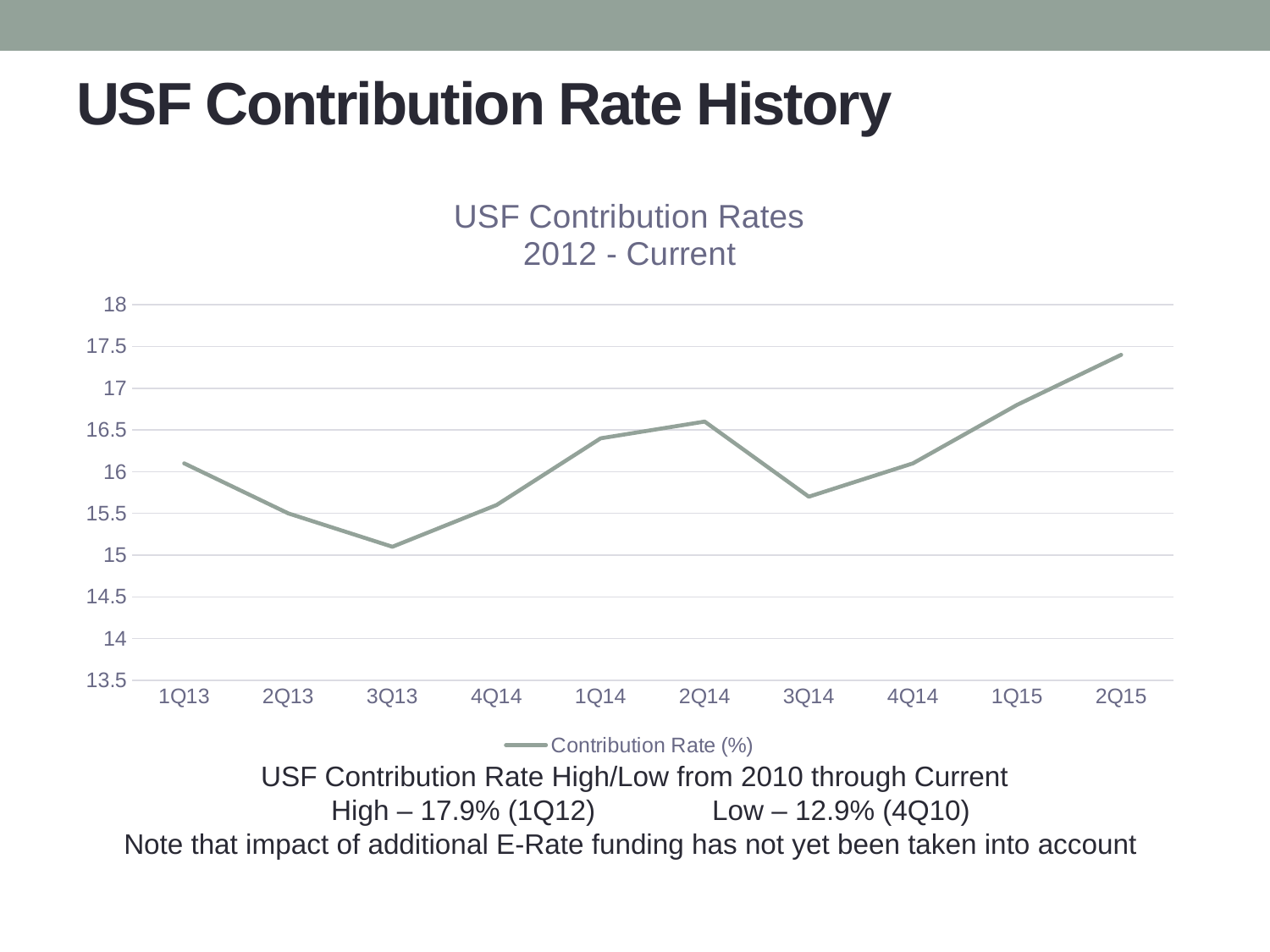
Is the contribution rate for 3Q14 greater or less than 16? less What is the title of the chart? USF Contribution Rates 2012 - Current Is the contribution rate for 2Q15 greater or less than 17? greater How many series does the legend list? 1 Is the contribution rate for 3Q13 greater or less than 15.5? less Which quarter has the highest contribution rate? 2Q15 Does the contribution rate rise or fall from 3Q14 to 2Q15? rise Which is larger, the contribution rate for 1Q13 or for 2Q15? 2Q15 Which quarter has the lowest contribution rate? 3Q13 What is the name of the series shown in the legend? Contribution Rate (%) How many quarters are plotted along the x axis? 10 What kind of chart is shown on the slide? line chart